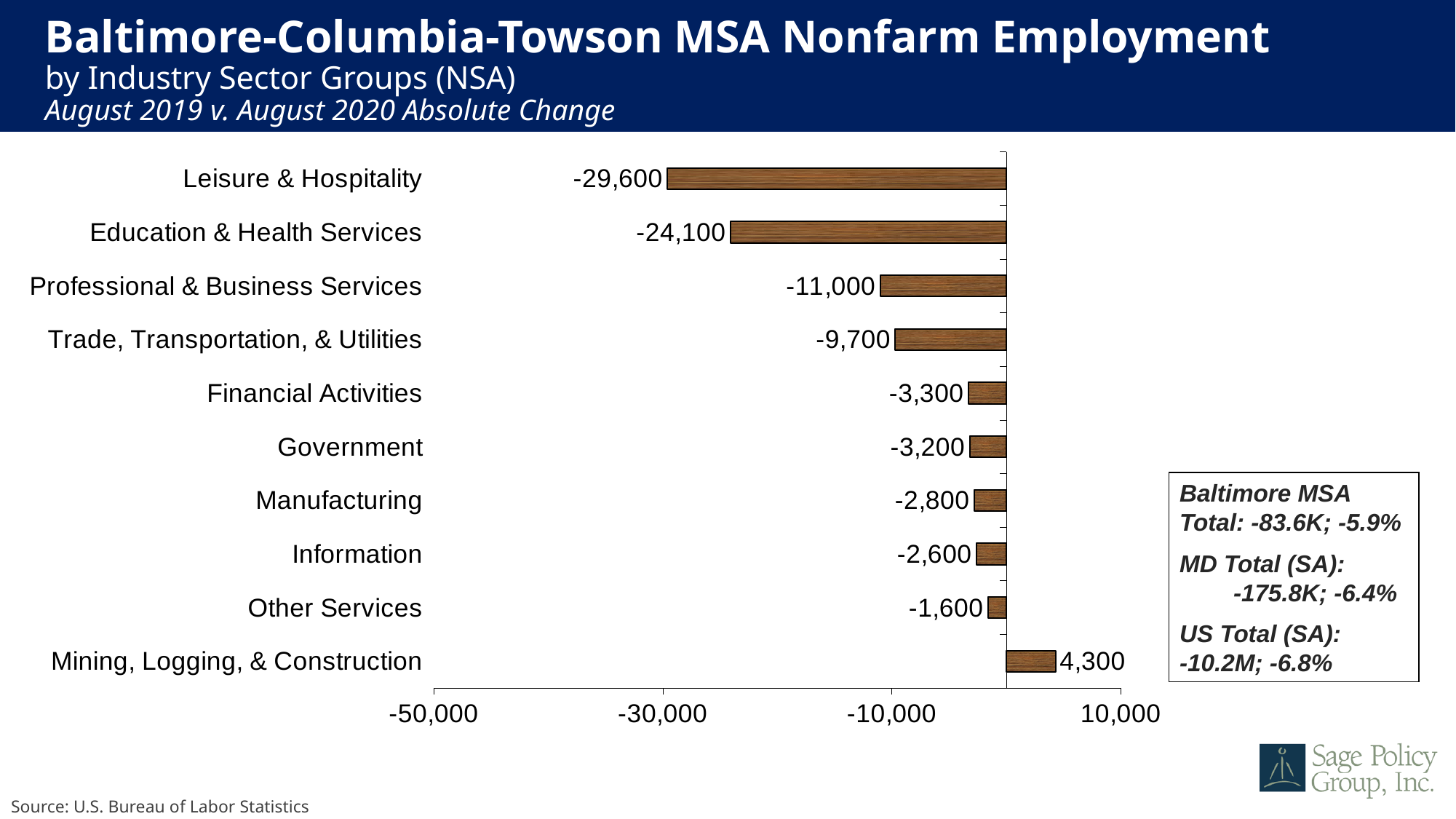
How many industry sector groups are shown in the chart? 10 What is the difference between the changes for Leisure & Hospitality and Education & Health Services? 5,500 What is the absolute change in employment for Trade, Transportation, & Utilities? -9,700 Which industry sector group is the only one with a positive change in employment? Mining, Logging, & Construction According to the text box, what is the Baltimore MSA total change in employment? -83.6K; -5.9% Which sector had a larger employment decline, Professional & Business Services or Trade, Transportation, & Utilities? Professional & Business Services Which industry sector group shows the largest employment decline? Leisure & Hospitality What is the absolute change in employment for Leisure & Hospitality? -29,600 What is the absolute change in employment for Mining, Logging, & Construction? 4,300 What is the absolute change in employment for Other Services? -1,600 What is the absolute change in employment for Education & Health Services? -24,100 What kind of chart is shown on the slide? Bar chart